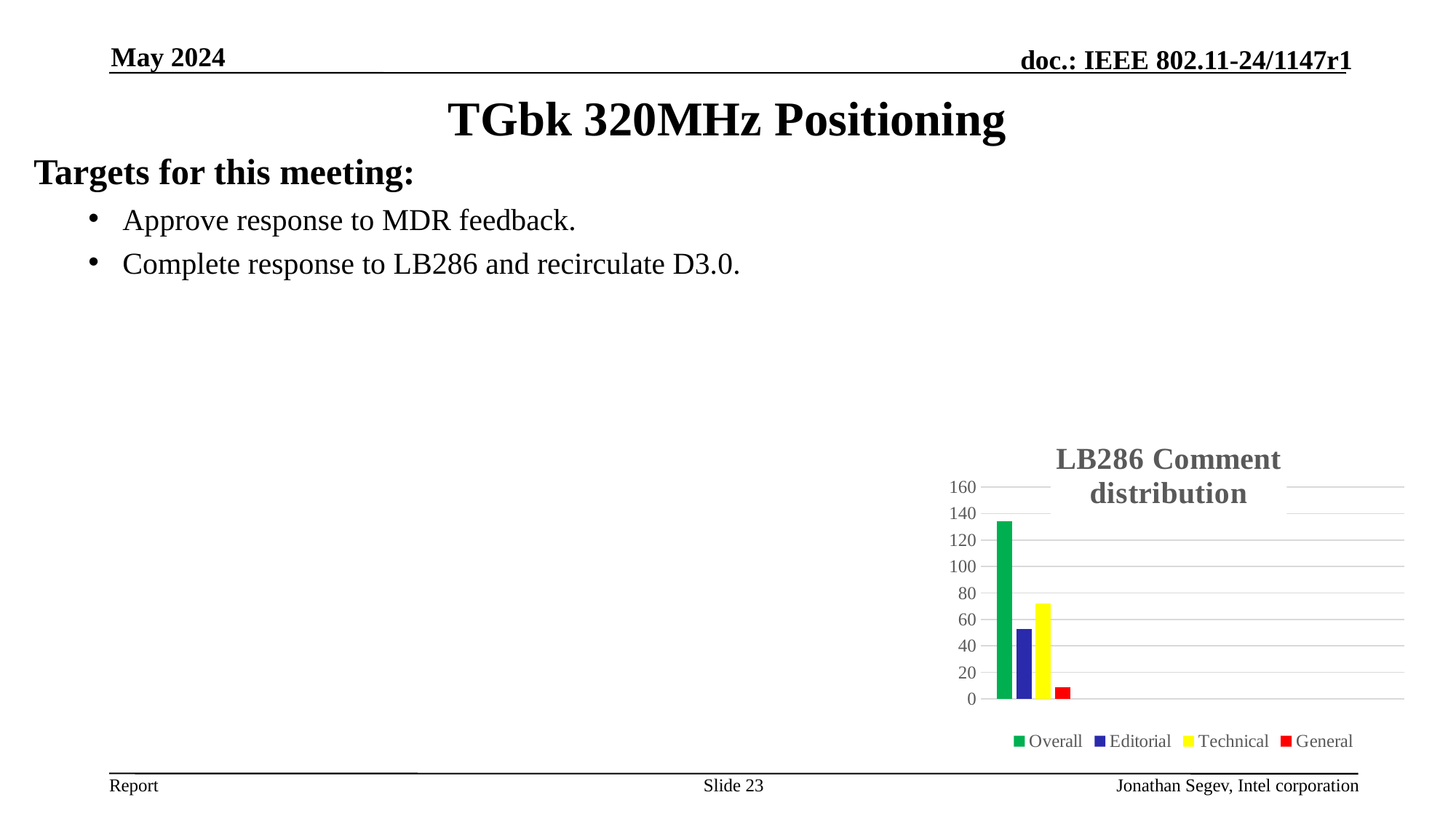
Which series has the highest value in the LB286 Comment distribution chart? Overall Which is larger in the chart, the value for General or the value for Editorial? Editorial What colour is the bar for the Technical series in the chart? yellow What is the title of the chart on the slide? LB286 Comment distribution What kind of chart is shown on the slide? bar chart Is the value for Editorial greater or less than 40? greater Which series has the lowest value in the LB286 Comment distribution chart? General Is the value for Overall greater or less than 120? greater Which is larger in the chart, the value for Editorial or the value for Technical? Technical Is the value for General greater or less than 20? less How many series does the chart's legend list? 4